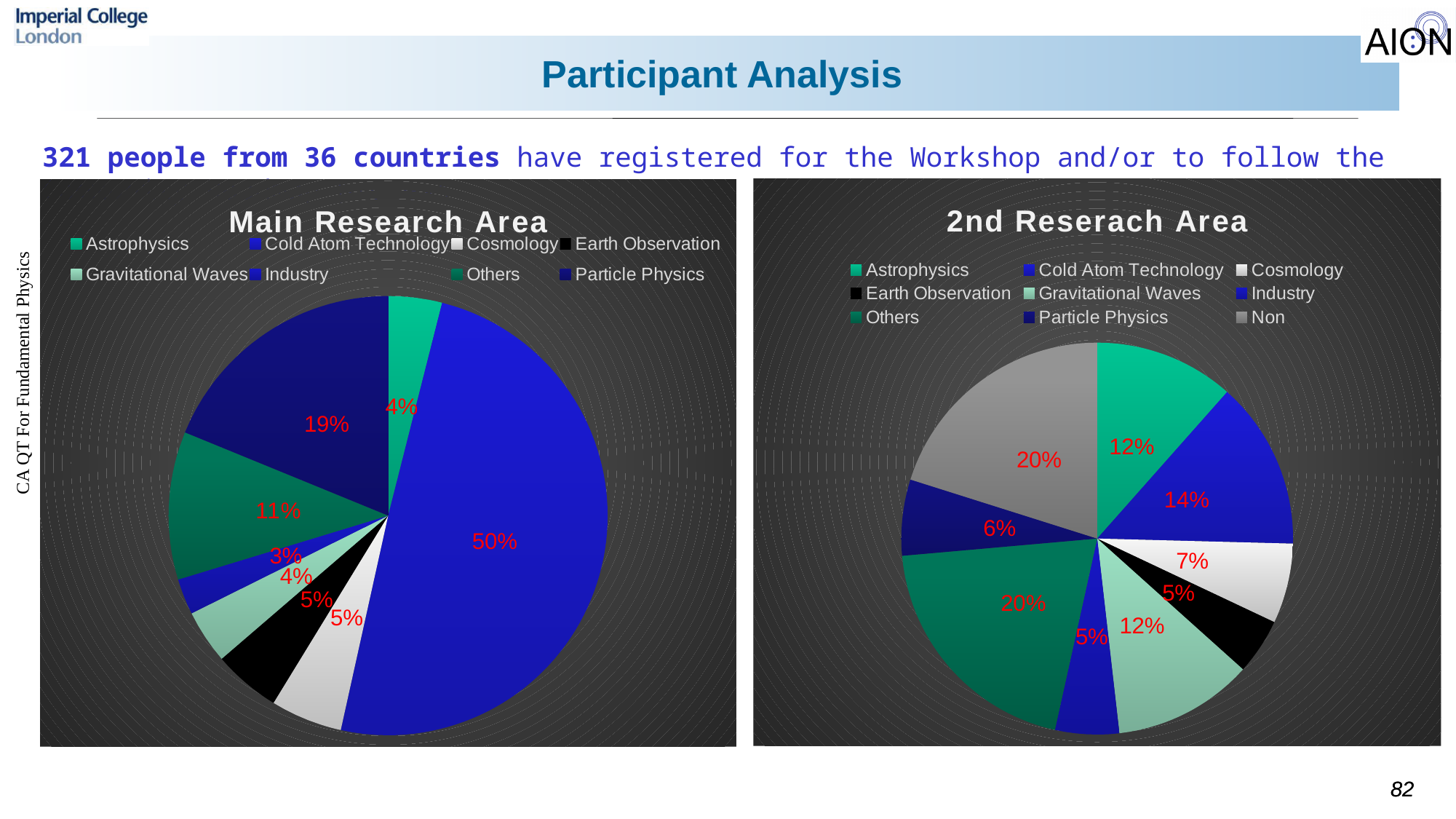
How many categories does the legend of the 2nd Reserach Area chart list? 9 What type of chart is the Main Research Area chart? Pie chart In the 2nd Reserach Area chart, what percentage is shown for Cosmology? 7% In the Main Research Area chart, which research area has the smallest share? Industry How many categories does the legend of the Main Research Area chart list? 8 In the Main Research Area chart, what is the difference between the Particle Physics share and the Others share? 8% In the Main Research Area chart, what percentage is shown for Particle Physics? 19% In the 2nd Reserach Area chart, what percentage is shown for Non? 20% In the 2nd Reserach Area chart, what percentage is shown for Cold Atom Technology? 14% In the Main Research Area chart, which research area has the largest share? Cold Atom Technology In the Main Research Area chart, what share of participants is Cold Atom Technology? 50% In the 2nd Reserach Area chart, which is larger: Astrophysics or Particle Physics? Astrophysics